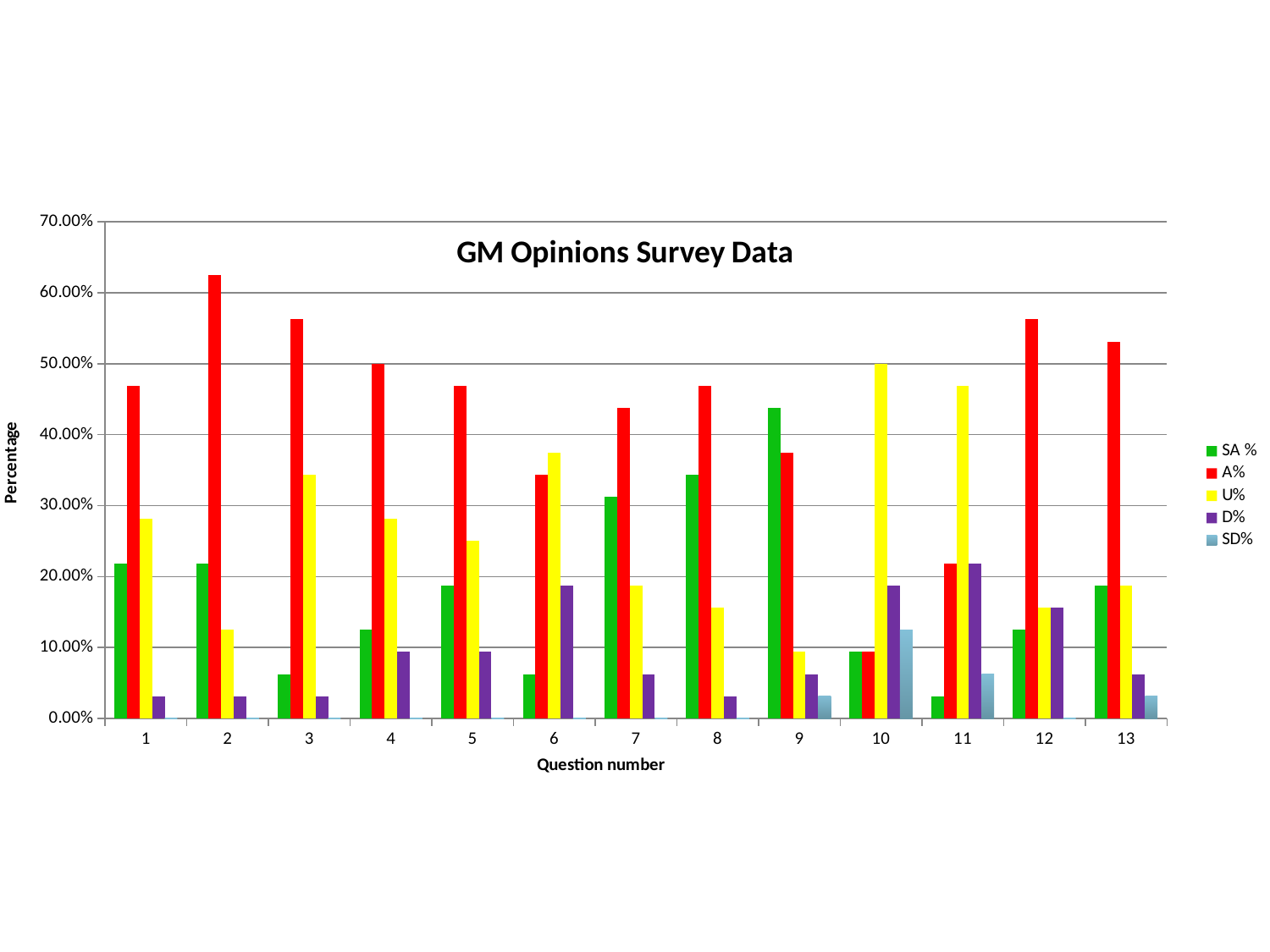
What is the title of the chart? GM Opinions Survey Data Is the SA % value for question 9 greater or less than 40.00%? greater How many question numbers are shown along the x axis? 13 Is the U% value for question 11 greater or less than 40.00%? greater Which question number has the lowest A% value? 10 What is the label of the x axis? Question number Which question number has the highest A% value? 2 For question 10, which is larger: U% or A%? U% Is the A% value for question 2 greater or less than 60.00%? greater How many series does the legend list? 5 What type of chart is shown on the slide? Bar chart For question 9, which is larger: SA % or A%? SA %